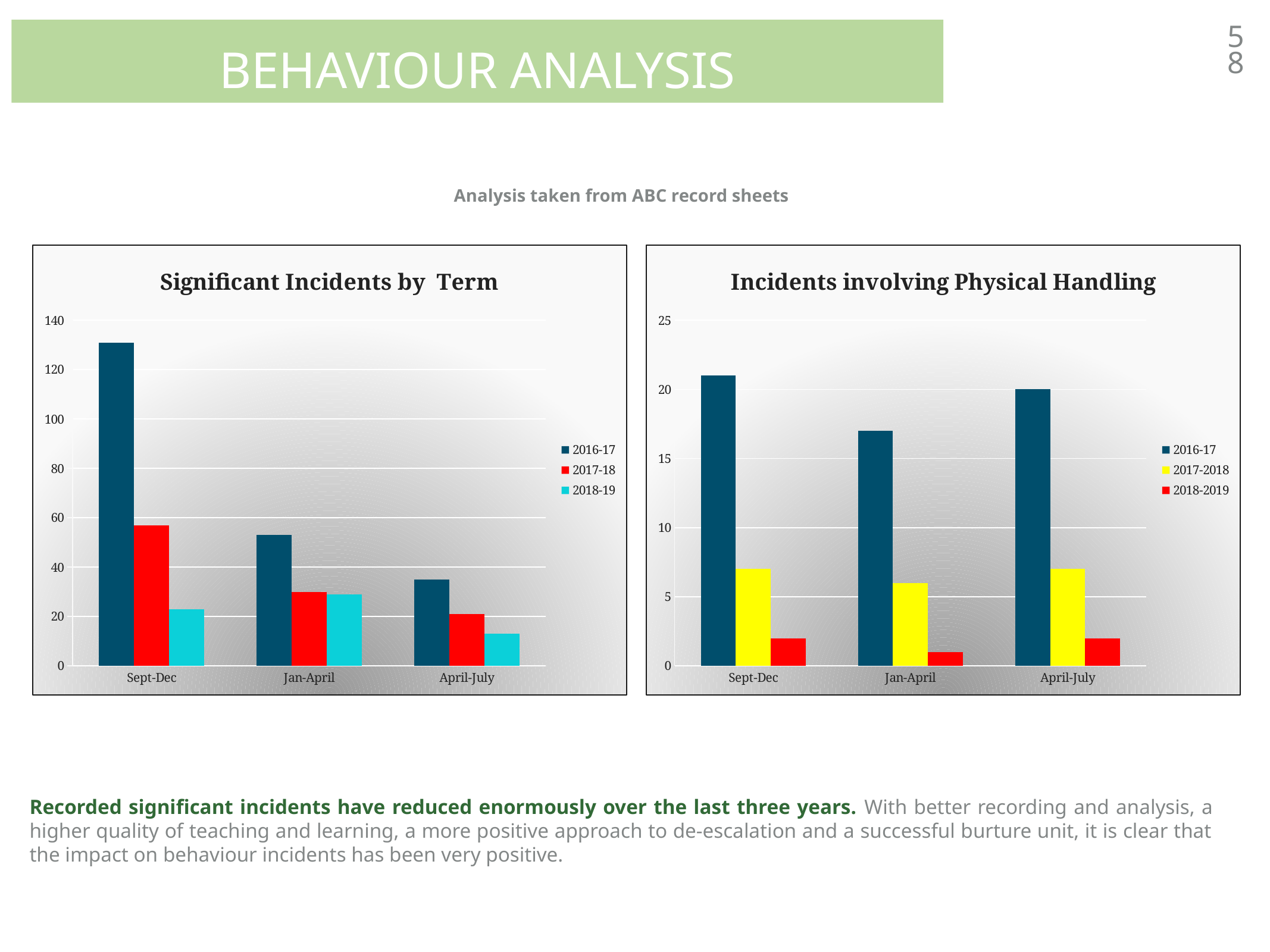
In the 'Significant Incidents by Term' chart, which is larger for Sept-Dec: 2017-18 or 2018-19? 2017-18 In the 'Significant Incidents by Term' chart, is the 2016-17 value for Sept-Dec greater or less than 120? greater In the 'Incidents involving Physical Handling' chart, is the 2018-2019 value for Jan-April greater or less than 5? less In the 'Incidents involving Physical Handling' chart, how many series does the legend list? 3 In the 'Significant Incidents by Term' chart, which term has the highest 2016-17 value? Sept-Dec What kind of chart is the 'Significant Incidents by Term' chart? bar chart In the 'Incidents involving Physical Handling' chart, which term has the lowest 2016-17 value? Jan-April In the 'Incidents involving Physical Handling' chart, which series is shown in yellow? 2017-2018 In the 'Significant Incidents by Term' chart, how many series does the legend list? 3 In the 'Significant Incidents by Term' chart, do the 2016-17 values rise or fall from Sept-Dec to April-July? fall In the 'Incidents involving Physical Handling' chart, is the 2016-17 value for Sept-Dec greater or less than 15? greater In the 'Significant Incidents by Term' chart, how many terms are shown on the x axis? 3